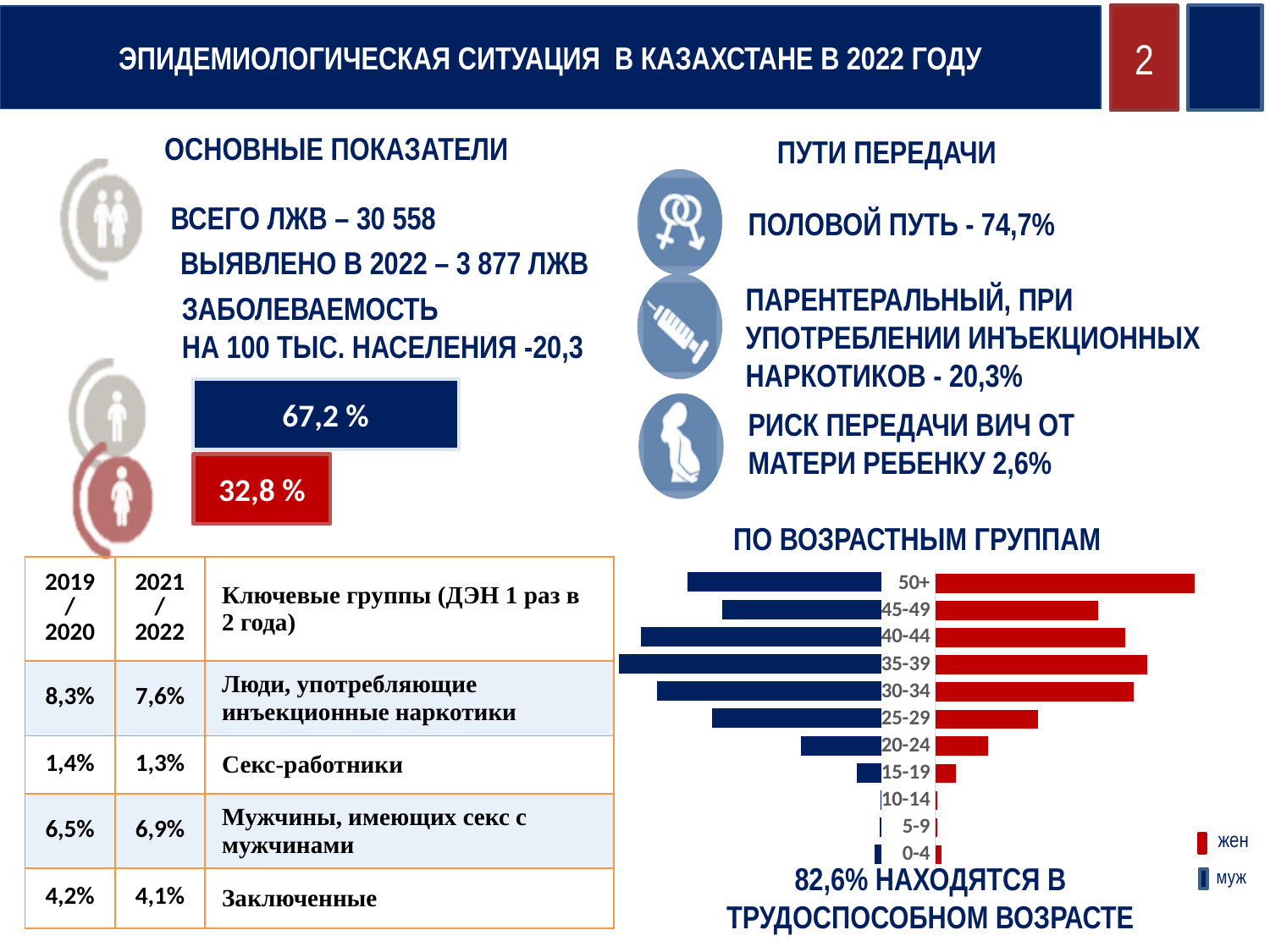
In the ПО ВОЗРАСТНЫМ ГРУППАМ chart, is the жен bar longer for 25-29 or for 20-24? 25-29 In the ПО ВОЗРАСТНЫМ ГРУППАМ chart, for the 35-39 age group, which series has the longer bar, жен or муж? муж How many series does the legend of the ПО ВОЗРАСТНЫМ ГРУППАМ chart list? 2 In the ПО ВОЗРАСТНЫМ ГРУППАМ chart, which age group has the longest bar for жен? 50+ In the ПО ВОЗРАСТНЫМ ГРУППАМ chart, is the муж bar longer for 50+ or for 45-49? 50+ In the ПО ВОЗРАСТНЫМ ГРУППАМ chart, which colour represents the жен series? red What are the two legend entries of the ПО ВОЗРАСТНЫМ ГРУППАМ chart? жен and муж In the ПО ВОЗРАСТНЫМ ГРУППАМ chart, which age group has the longest bar for муж? 35-39 What kind of chart is shown under the heading ПО ВОЗРАСТНЫМ ГРУППАМ? bar chart How many age groups are plotted in the ПО ВОЗРАСТНЫМ ГРУППАМ chart? 11 In the ПО ВОЗРАСТНЫМ ГРУППАМ chart, do the муж bars get longer or shorter going from the 0-4 group up to the 35-39 group? longer